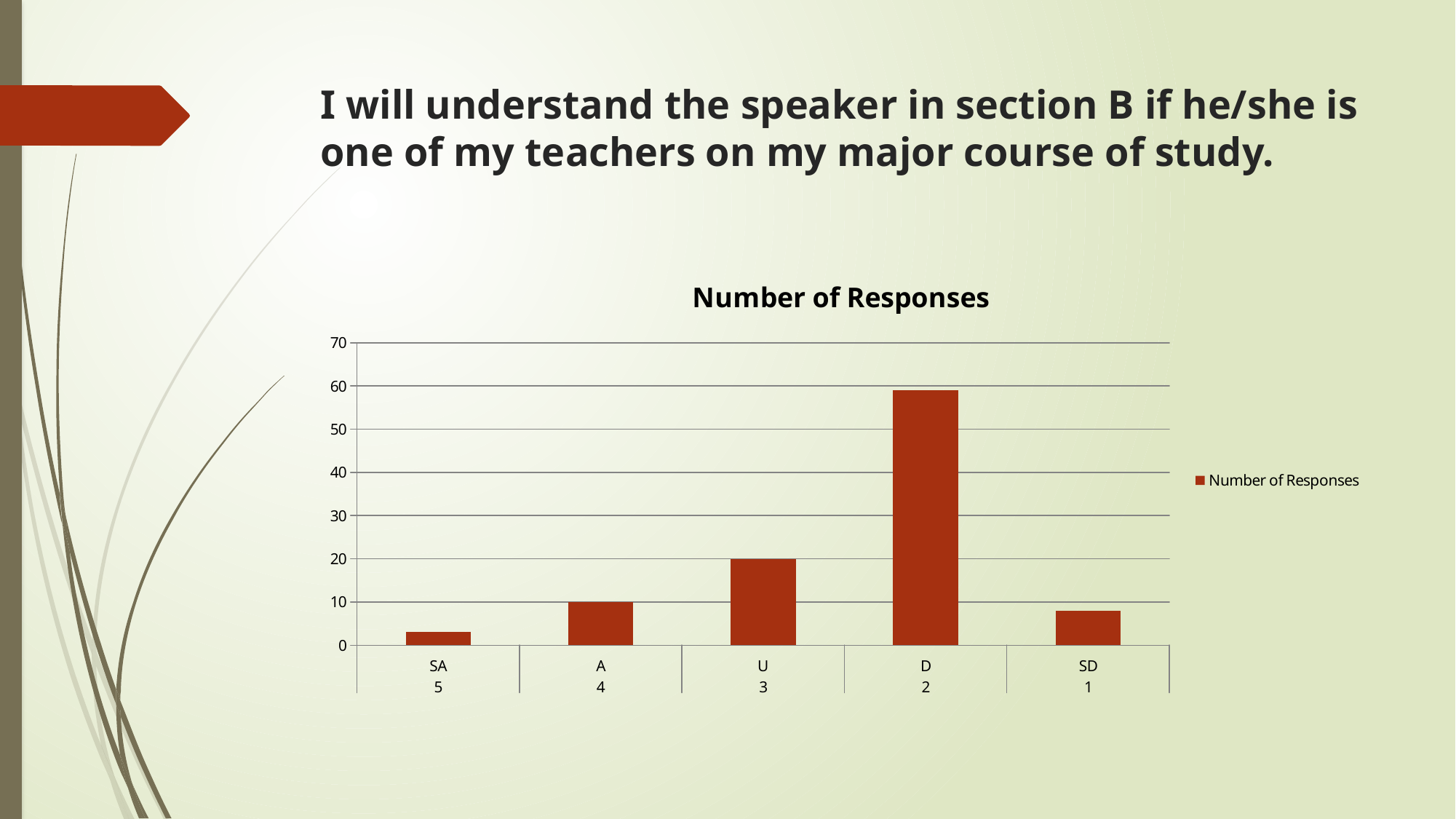
How many categories are shown on the x axis of the chart? 5 What is the number of responses for U? 20 Which has more responses, U or SD? U What type of chart is shown on the slide? bar chart Is the value for SD greater or less than 10? less Is the value for D greater or less than 50? greater What is the number of responses for A? 10 How many series does the legend list? 1 Which category has the lowest number of responses? SA What is the difference between the number of responses for U and A? 10 Which category has the highest number of responses? D What is the title of the chart? Number of Responses